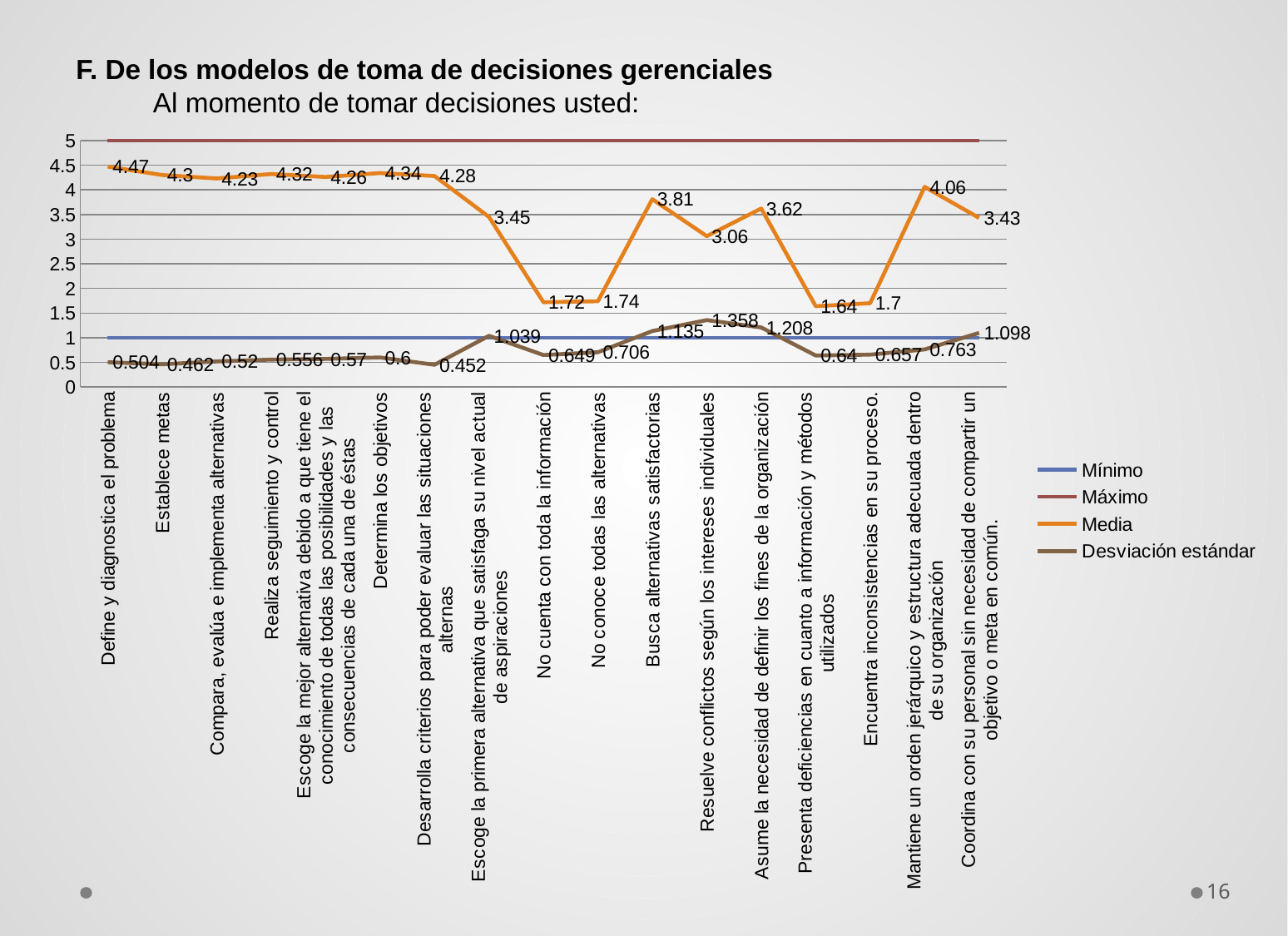
What is the Desviación estándar value for "Resuelve conflictos según los intereses individuales"? 1.358 Which category has the highest Media value? Define y diagnostica el problema What kind of chart is shown on the slide? Line chart Which category has the lowest Desviación estándar value? Desarrolla criterios para poder evaluar las situaciones alternas Which has a higher Media value: "No cuenta con toda la información" or "Escoge la primera alternativa que satisfaga su nivel actual de aspiraciones"? Escoge la primera alternativa que satisfaga su nivel actual de aspiraciones How many series does the legend list? 4 What is the Media value for "Mantiene un orden jerárquico y estructura adecuada dentro de su organización"? 4.06 What is the Media value for "Define y diagnostica el problema"? 4.47 Which category has the lowest Media value? Presenta deficiencias en cuanto a información y métodos utilizados Is the Media value for "Coordina con su personal sin necesidad de compartir un objetivo o meta en común." greater or less than 3? greater What is the difference between the Media values for "Busca alternativas satisfactorias" and "Resuelve conflictos según los intereses individuales"? 0.75 How many categories are shown on the x axis of the chart? 17